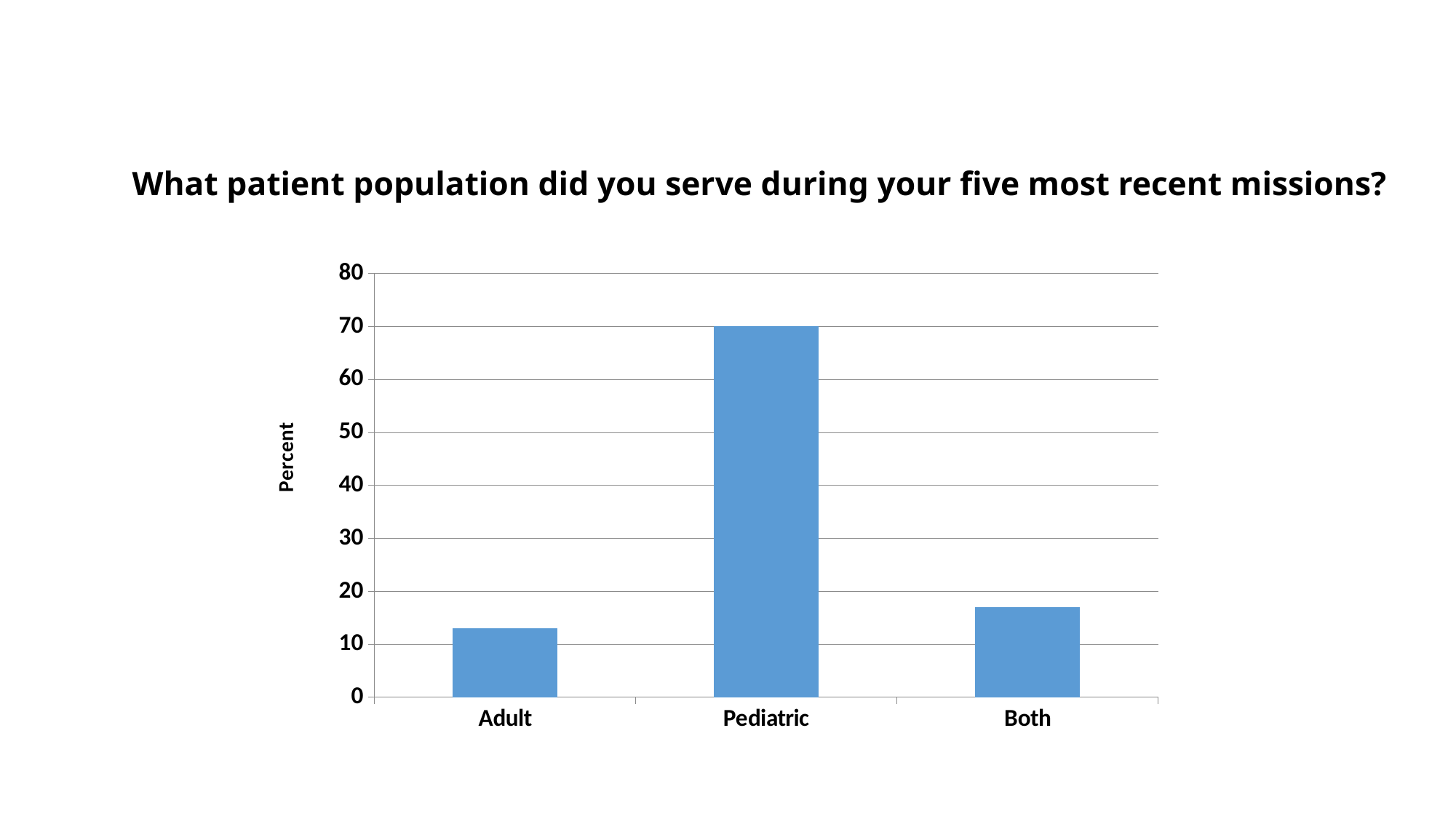
Which category has the highest value in the chart? Pediatric What kind of chart is shown on the slide? Bar chart Is the value for Adult greater or less than 10? greater Is the value for Both greater or less than 20? less How many categories are shown on the x axis of the chart? 3 Is the value for Pediatric greater or less than 60? greater Which is larger, the value for Adult or the value for Both? Both What is the label on the vertical axis of the chart? Percent What is the title of the chart? What patient population did you serve during your five most recent missions? Which category has the lowest value in the chart? Adult What is the value for Pediatric in the chart? 70